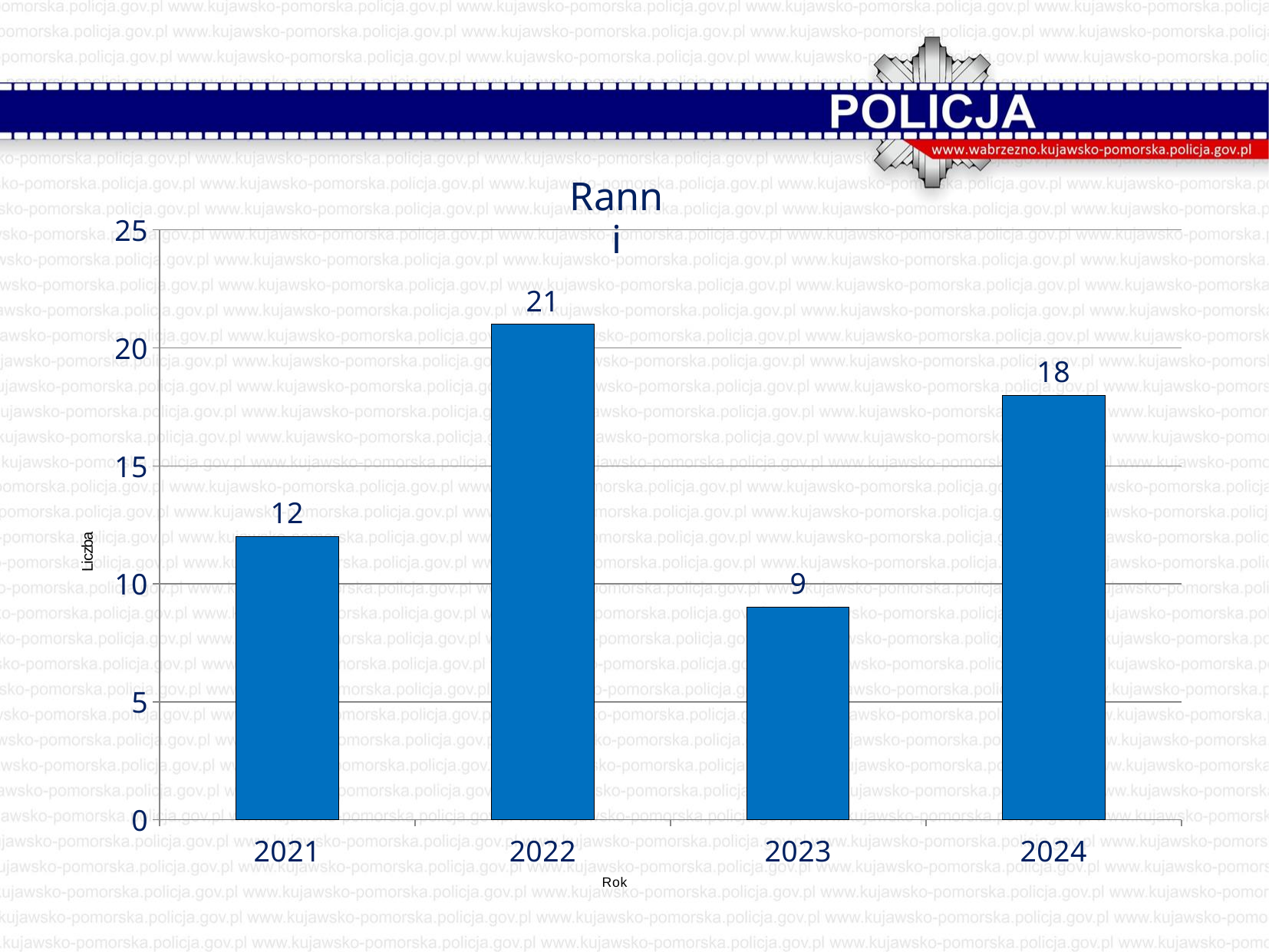
What is the value for 2024? 18 What is the value for 2022? 21 What is the title of the chart? Ranni What is the value for 2023? 9 Is the value for 2023 greater or less than 10? less What is the difference between the values for 2022 and 2023? 12 How many years are shown on the x axis? 4 Which year has the lowest value? 2023 Which year has the highest value? 2022 What kind of chart is shown? bar chart Which is larger, the value for 2021 or the value for 2024? 2024 What is the value for 2021? 12